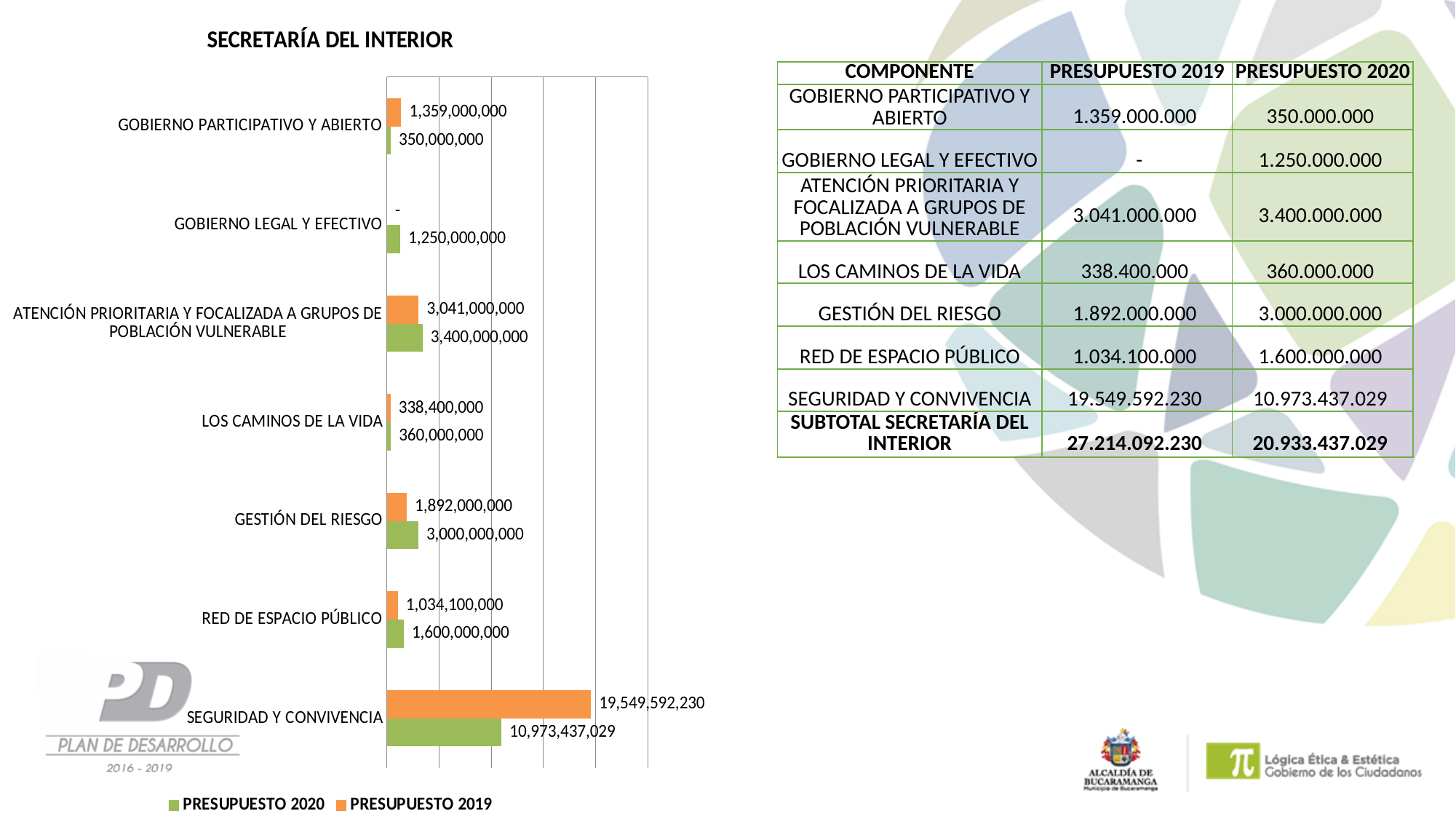
How many series does the chart legend list? 2 What is the PRESUPUESTO 2019 value for LOS CAMINOS DE LA VIDA? 338,400,000 What is the PRESUPUESTO 2019 value for SEGURIDAD Y CONVIVENCIA? 19,549,592,230 Which colour represents PRESUPUESTO 2019 in the chart? Orange How many categories are shown on the chart? 7 For RED DE ESPACIO PÚBLICO, which is larger: PRESUPUESTO 2019 or PRESUPUESTO 2020? PRESUPUESTO 2020 What is the PRESUPUESTO 2020 value for GESTIÓN DEL RIESGO? 3,000,000,000 What kind of chart is shown on the slide? Bar chart What is the difference between the PRESUPUESTO 2019 and PRESUPUESTO 2020 values for SEGURIDAD Y CONVIVENCIA? 8,576,155,201 What is the PRESUPUESTO 2020 value for GOBIERNO LEGAL Y EFECTIVO? 1,250,000,000 Which category has the lowest PRESUPUESTO 2020 value? GOBIERNO PARTICIPATIVO Y ABIERTO Which category has the highest PRESUPUESTO 2020 value? SEGURIDAD Y CONVIVENCIA